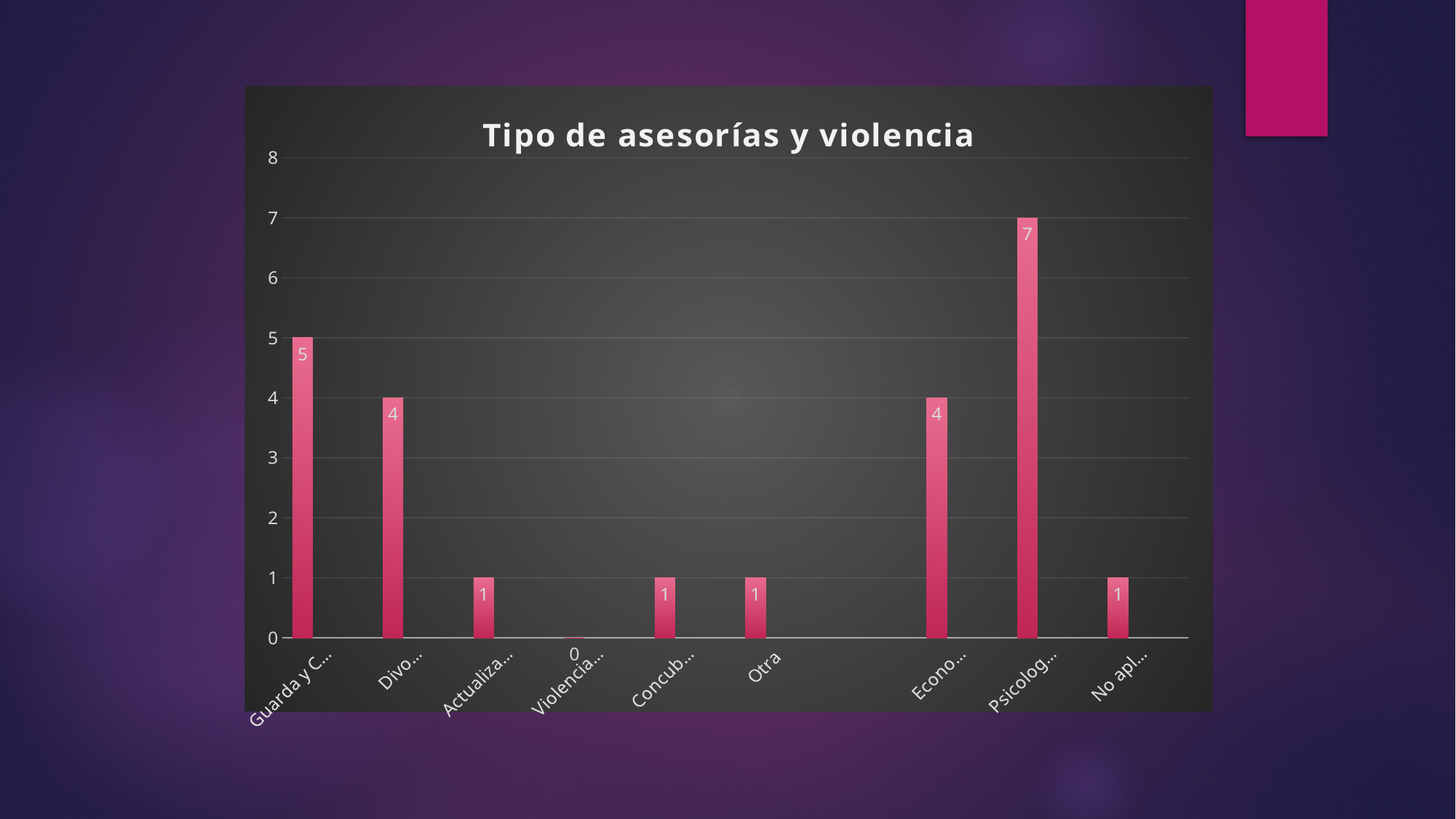
What is the value of the first bar on the left (labelled 'Guarda y C...')? 5 Which category has a value of 0? Violencia... How many bars have a value of 1? 4 What is the title of the chart? Tipo de asesorías y violencia What is the value for the category 'Otra'? 1 Which is larger, the value for 'Divo...' or the value for 'Otra'? Divo... What is the difference between the value for 'Psicolog...' and the value for 'Guarda y C...'? 2 Is the value for 'Psicolog...' greater or less than 6? greater What is the maximum value shown on the vertical axis? 8 Which category has the highest value? Psicolog... What type of chart is shown on the slide? Bar chart What is the value of the tallest bar (labelled 'Psicolog...')? 7